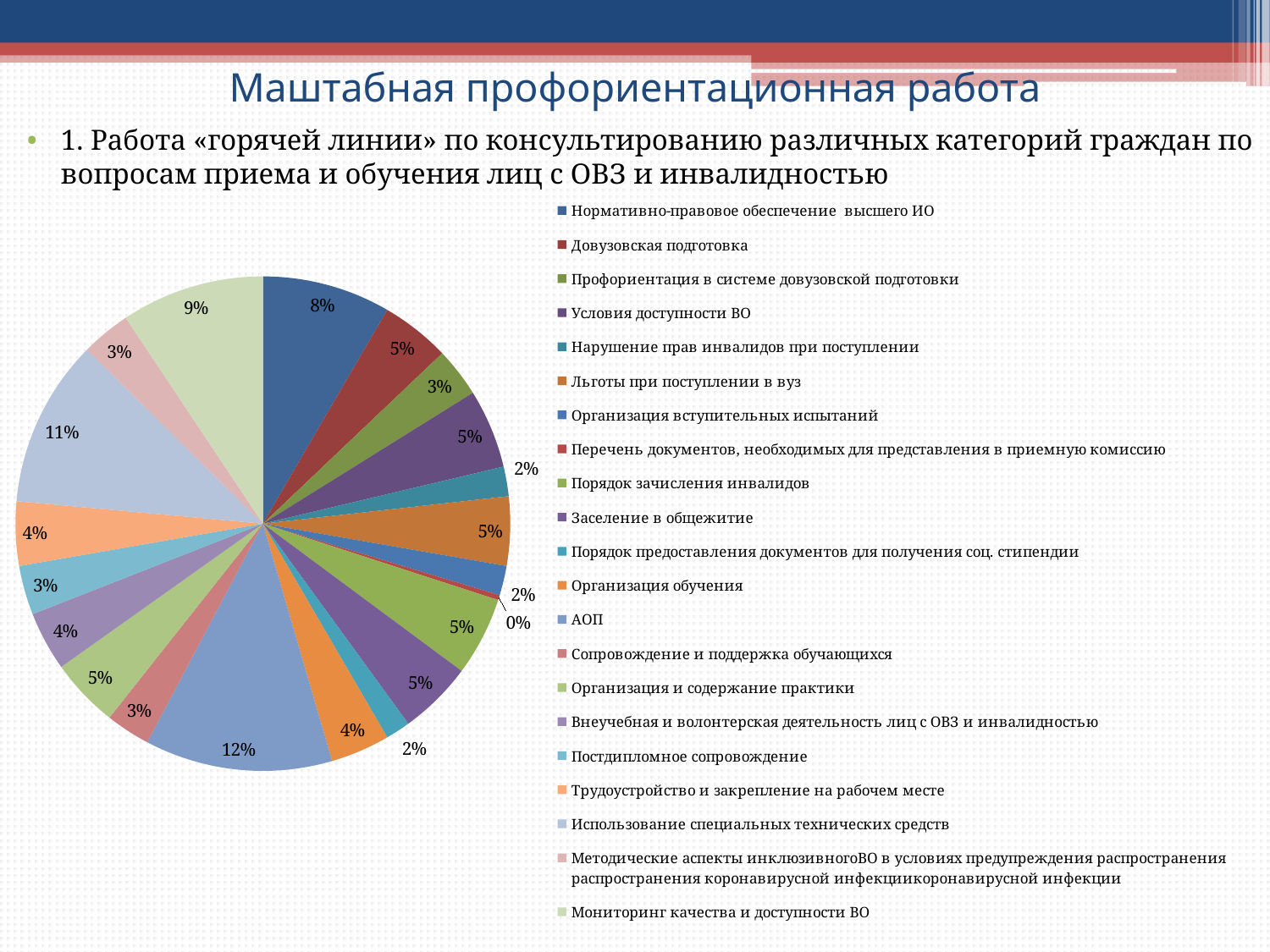
Which category has the largest slice of the pie? АОП Which slice is larger: Использование специальных технических средств or Нормативно-правовое обеспечение высшего ИО? Использование специальных технических средств What share of the pie does АОП account for? 12% How many categories does the legend of the pie chart list? 21 What share of the pie does Довузовская подготовка account for? 5% What share of the pie does Нормативно-правовое обеспечение высшего ИО account for? 8% Which category has the smallest slice of the pie? Перечень документов, необходимых для представления в приемную комиссию What kind of chart is shown on the slide? pie chart What is the difference in percentage points between the АОП slice and the Мониторинг качества и доступности ВО slice? 3%